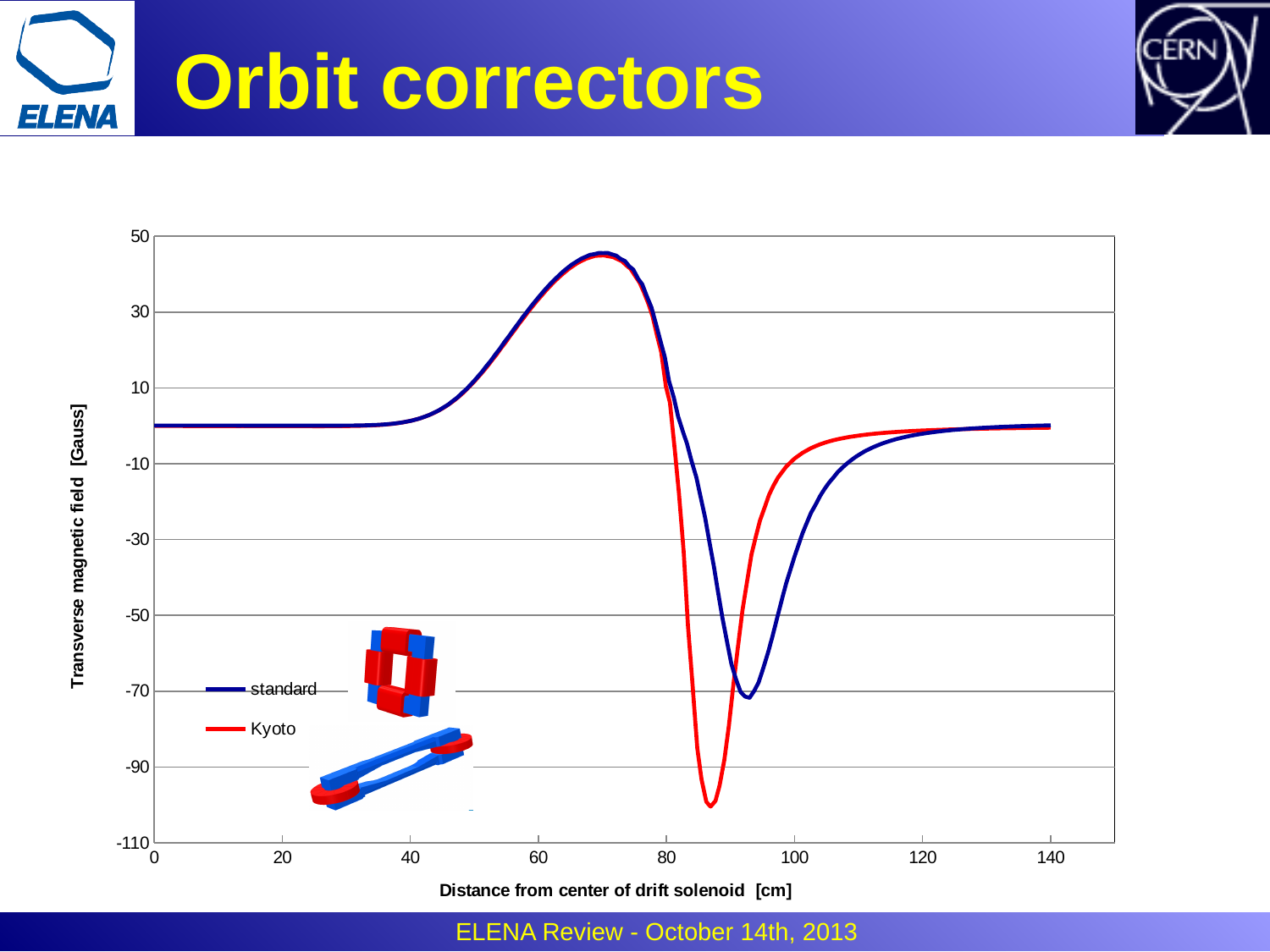
Is the minimum value of the standard series greater or less than -50? less What is the title of the x axis? Distance from center of drift solenoid [cm] Is the minimum value of the Kyoto series greater or less than -90? less Is the value of the Kyoto series at 20 cm greater or less than 10? less Do the values of the Kyoto series rise or fall between 70 cm and 85 cm? fall Do the values of the standard series rise or fall between 40 cm and 70 cm? rise Which series reaches the lower minimum value, standard or Kyoto? Kyoto What kind of chart is shown on the slide? line chart How many series does the legend list? 2 What are the two series named in the legend? standard and Kyoto Which series returns to zero sooner after its negative dip, standard or Kyoto? Kyoto